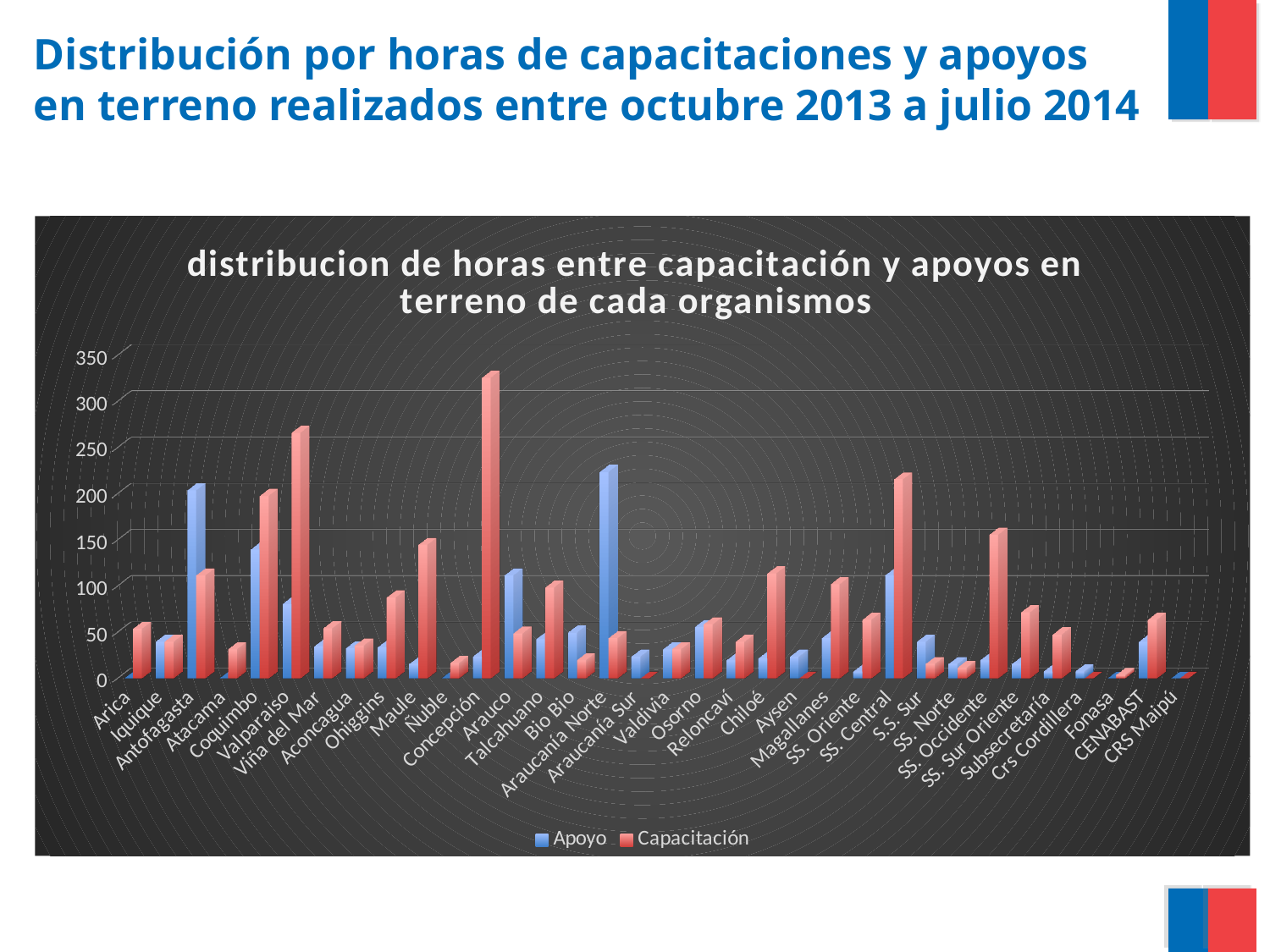
Which series is shown in blue? Apoyo Which is larger, the Capacitación value for Concepción or for Valparaíso? Concepción What is the title of the chart? distribucion de horas entre capacitación y apoyos en terreno de cada organismos How many series does the legend list? 2 Which is larger, the Apoyo value for Antofagasta or for Atacama? Antofagasta For Coquimbo, which series has the larger value, Apoyo or Capacitación? Capacitación Is the Apoyo value for Antofagasta greater or less than 150? greater What kind of chart is shown on the slide? bar chart Which category has the highest Capacitación value? Concepción Is the Capacitación value for Maule greater or less than 100? greater Is the Capacitación value for Valparaíso greater or less than 200? greater